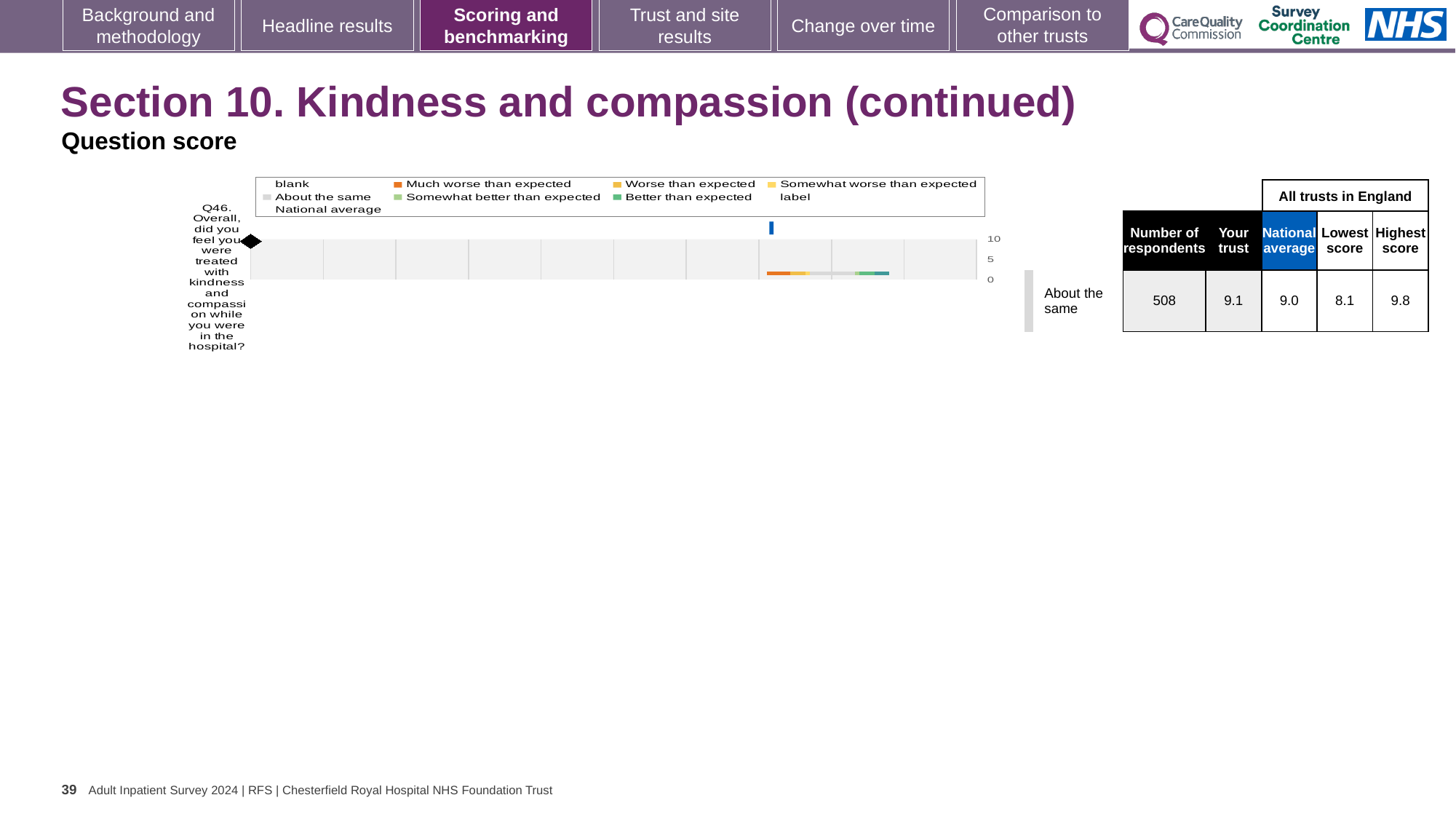
What is the national average score for Q46? 9.0 What is the highest score among all trusts in England for Q46? 9.8 What is the 'Your trust' score for Q46? 9.1 Which is larger for Q46, the 'Your trust' score or the national average? Your trust How many questions (categories) are plotted on the chart? 1 How many entries does the chart's legend list? 9 What is the difference between the highest score and the lowest score for Q46? 1.7 Which legend entry is shown in orange? Much worse than expected What kind of chart is shown on the slide for Q46? bar chart What is the lowest score among all trusts in England for Q46? 8.1 What is the highest value shown on the chart's axis? 10 What is the number of respondents for Q46? 508